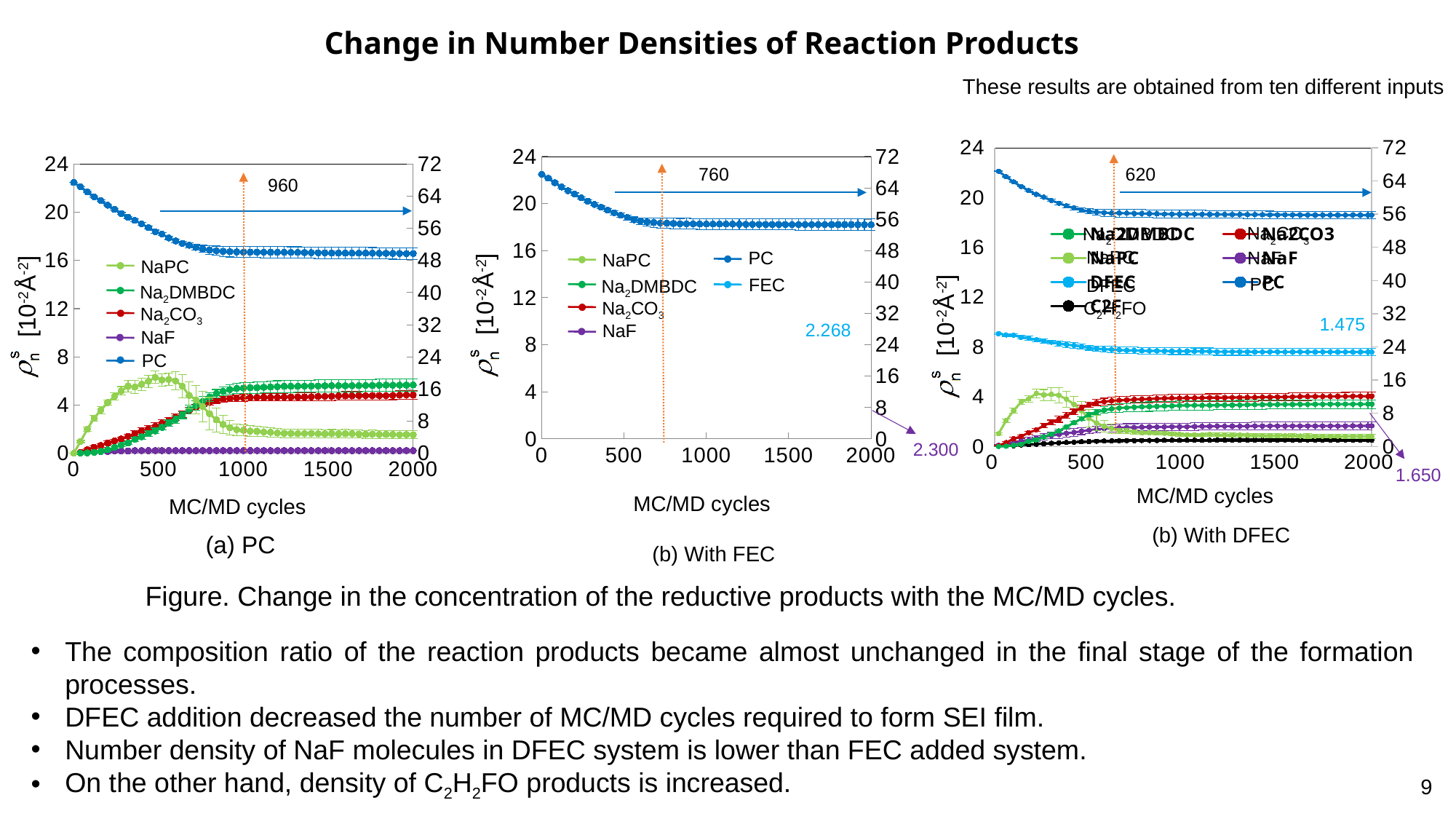
What kind of chart is used in panel (a) PC? line chart In the (b) With DFEC chart, what number is printed next to the dotted vertical arrow? 620 In the (a) PC chart, does the PC series rise or fall as the MC/MD cycles increase? fall In the (a) PC chart, what number is printed next to the dotted vertical arrow? 960 In the (b) With DFEC chart, what value is printed in purple at the lower right, pointed to by the arrow? 1.650 In the (a) PC chart, how many series does the legend list? 5 In the (a) PC chart, which series has the lowest value at 2000 MC/MD cycles? NaF What is the x-axis label of the (a) PC chart? MC/MD cycles In the (b) With FEC chart, what value is printed in cyan near the right side of the plot? 2.268 In the (a) PC chart, is the value for NaPC at 500 MC/MD cycles greater or less than 4 on the left axis? greater In the (b) With FEC chart, what number is printed next to the dotted vertical arrow? 760 In the (b) With FEC chart, how many series does the legend list? 6